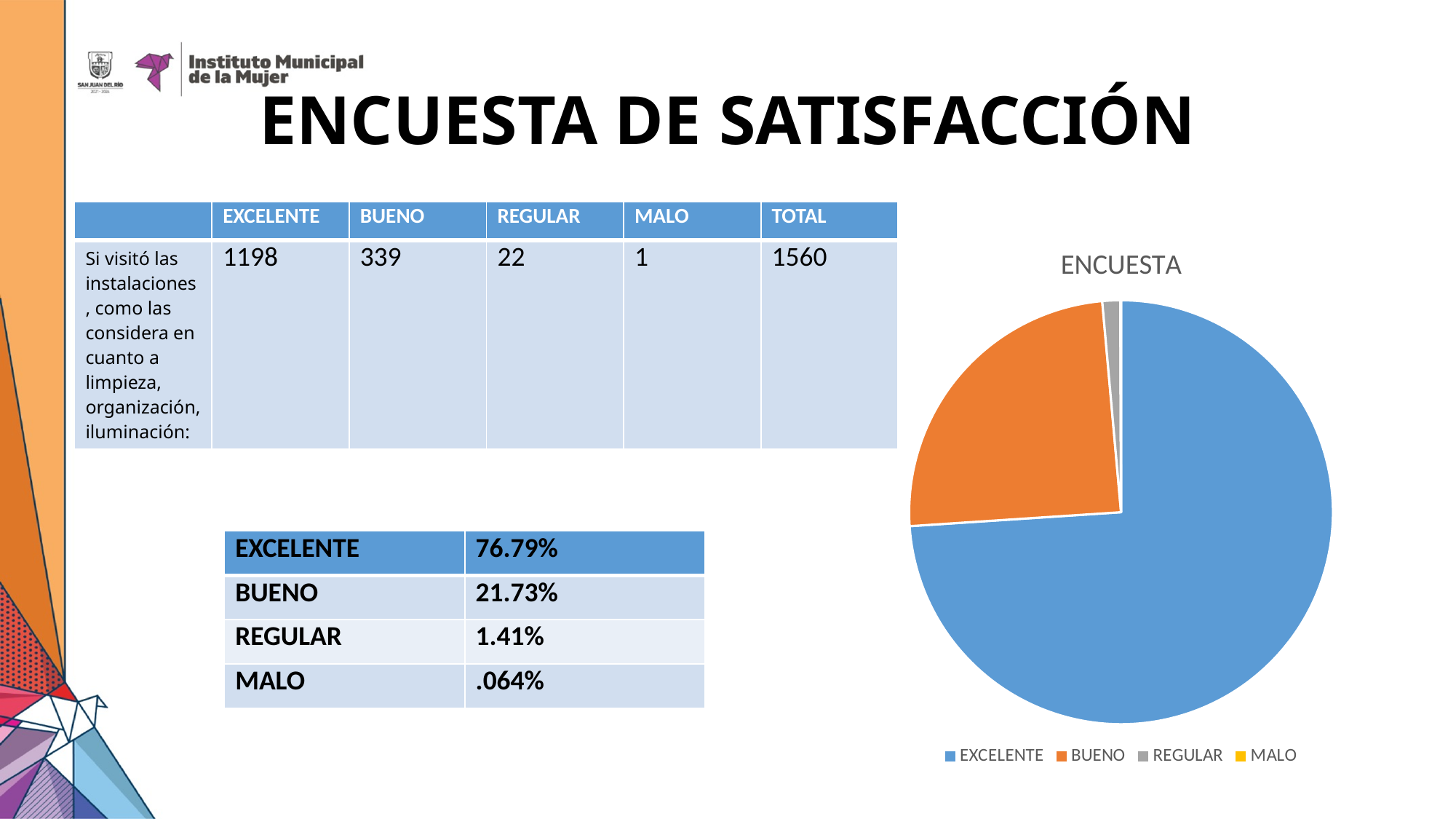
What kind of chart is the ENCUESTA chart? pie chart Which category has the largest slice in the ENCUESTA pie chart? EXCELENTE How many categories does the legend of the ENCUESTA pie chart list? 4 In the ENCUESTA pie chart, which is larger, BUENO or REGULAR? BUENO What is the value for EXCELENTE shown on the slide? 1198 What is the total of all responses shown on the slide? 1560 What share of the ENCUESTA pie does BUENO represent? 21.73% What is the title of the pie chart? ENCUESTA Which category has the smallest slice in the ENCUESTA pie chart? MALO What colour is the EXCELENTE slice in the ENCUESTA pie chart? blue What share of the ENCUESTA pie does EXCELENTE represent? 76.79% What is the value for REGULAR shown on the slide? 22